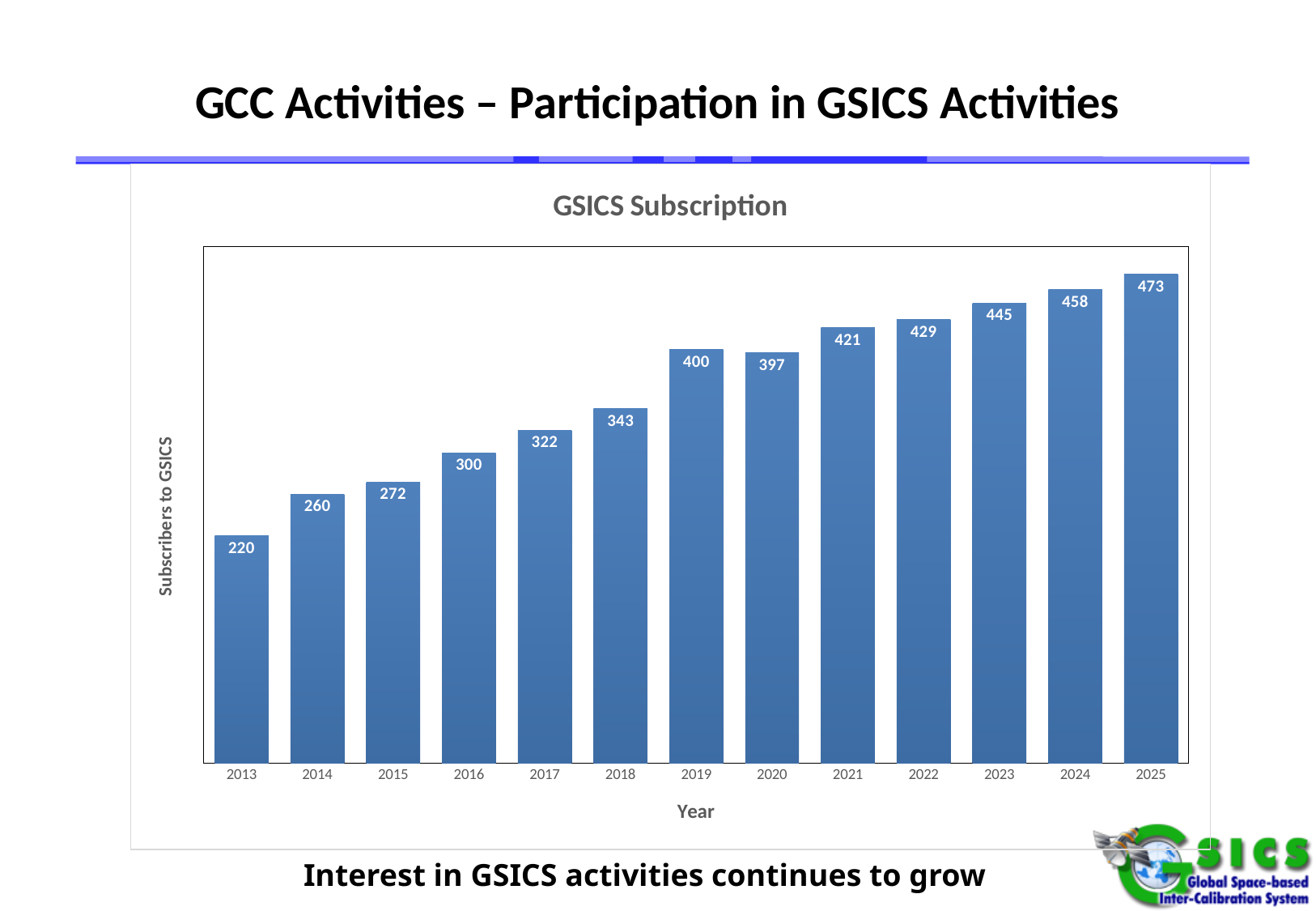
What is the difference in subscribers between 2025 and 2013? 253 Do the subscriber numbers generally rise or fall from 2013 to 2025? Rise Which year has the lowest number of subscribers to GSICS? 2013 What is the title of the chart? GSICS Subscription What is the number of subscribers to GSICS in 2019? 400 How many years are shown on the x axis of the chart? 13 What is the number of subscribers to GSICS in 2013? 220 Which year had more subscribers, 2019 or 2020? 2019 What type of chart is shown on the slide? Bar chart What is the difference in subscribers between 2019 and 2020? 3 What is the number of subscribers to GSICS in 2022? 429 Which year has the highest number of subscribers to GSICS? 2025